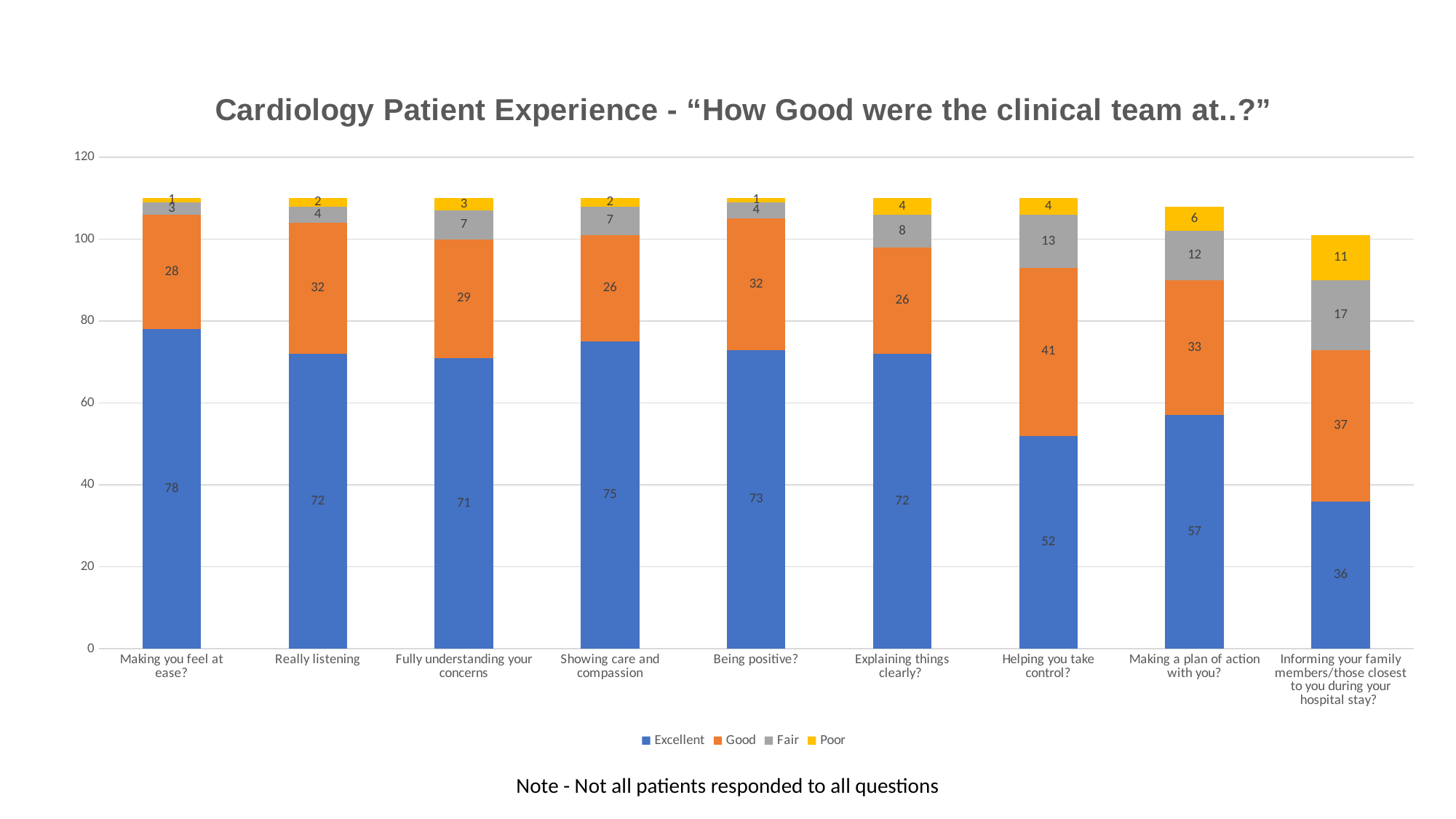
How many categories are shown on the x axis? 9 What kind of chart is shown on the slide? Stacked bar chart What is the title of the chart? Cardiology Patient Experience - "How Good were the clinical team at..?" Which is larger, the Fair value for "Helping you take control?" or the Fair value for "Making a plan of action with you?"? Helping you take control? Which category has the lowest Excellent value? Informing your family members/those closest to you during your hospital stay? What is the Good value for "Helping you take control?"? 41 What is the Poor value for "Informing your family members/those closest to you during your hospital stay?"? 11 What is the total of the stacked bar for "Making a plan of action with you?"? 108 What is the Excellent value for "Making you feel at ease?"? 78 Which category has the highest Excellent value? Making you feel at ease? What is the difference between the Excellent values for "Making you feel at ease?" and "Helping you take control?"? 26 How many series does the legend list? 4